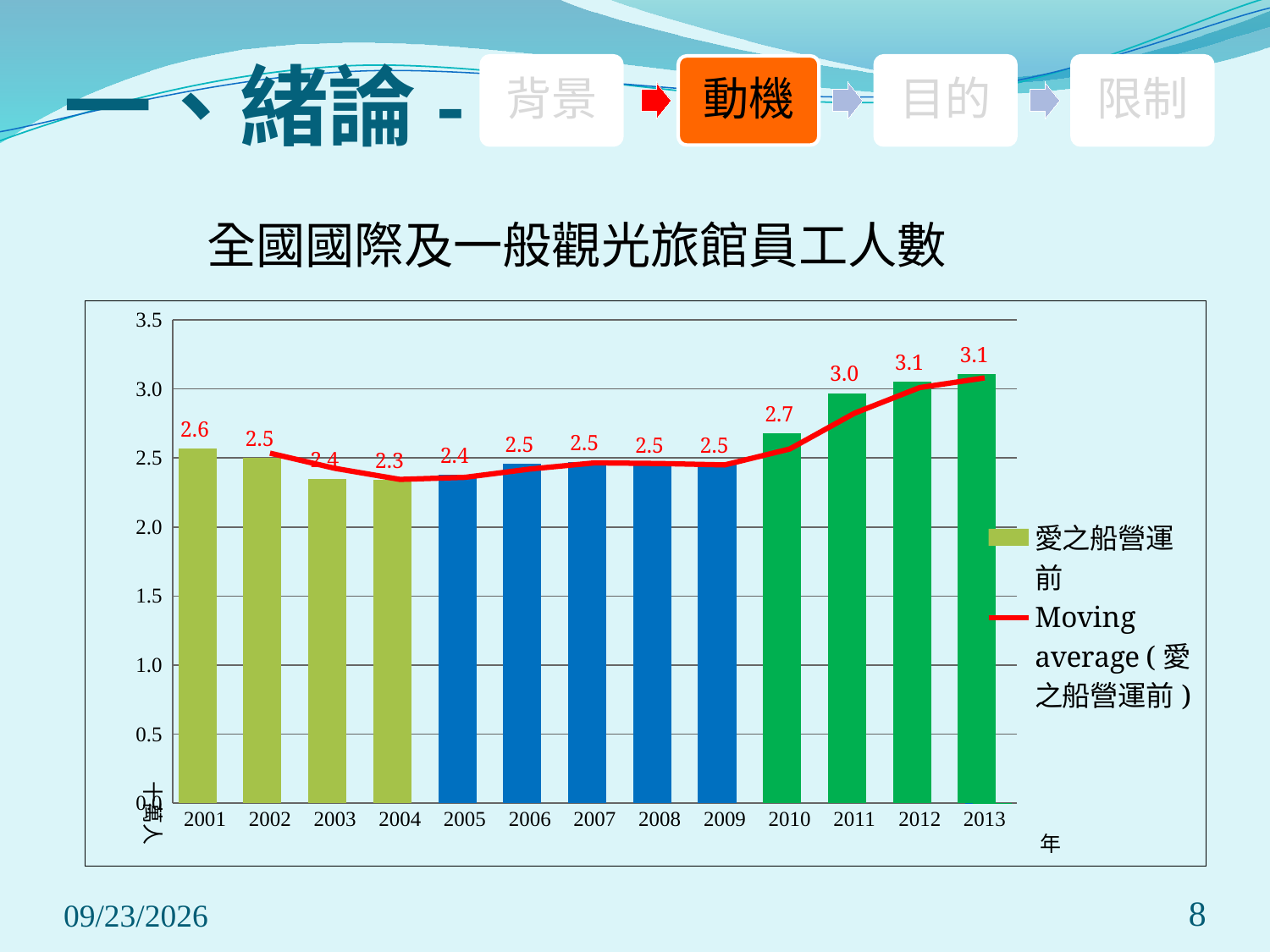
Do the values rise or fall from 2009 to 2013? rise What is the difference between the values for 2013 and 2004? 0.8 How many entries does the legend list? 2 How many years are shown on the x axis? 13 What is the value for 2004? 2.3 What is the title of the chart? 全國國際及一般觀光旅館員工人數 What is the value for 2011? 3.0 Which year has the lowest value? 2004 Which is larger, the value for 2010 or the value for 2009? 2010 Is the value for 2012 greater or less than 3.0? greater What is the value for 2001? 2.6 What kind of chart is this? bar chart